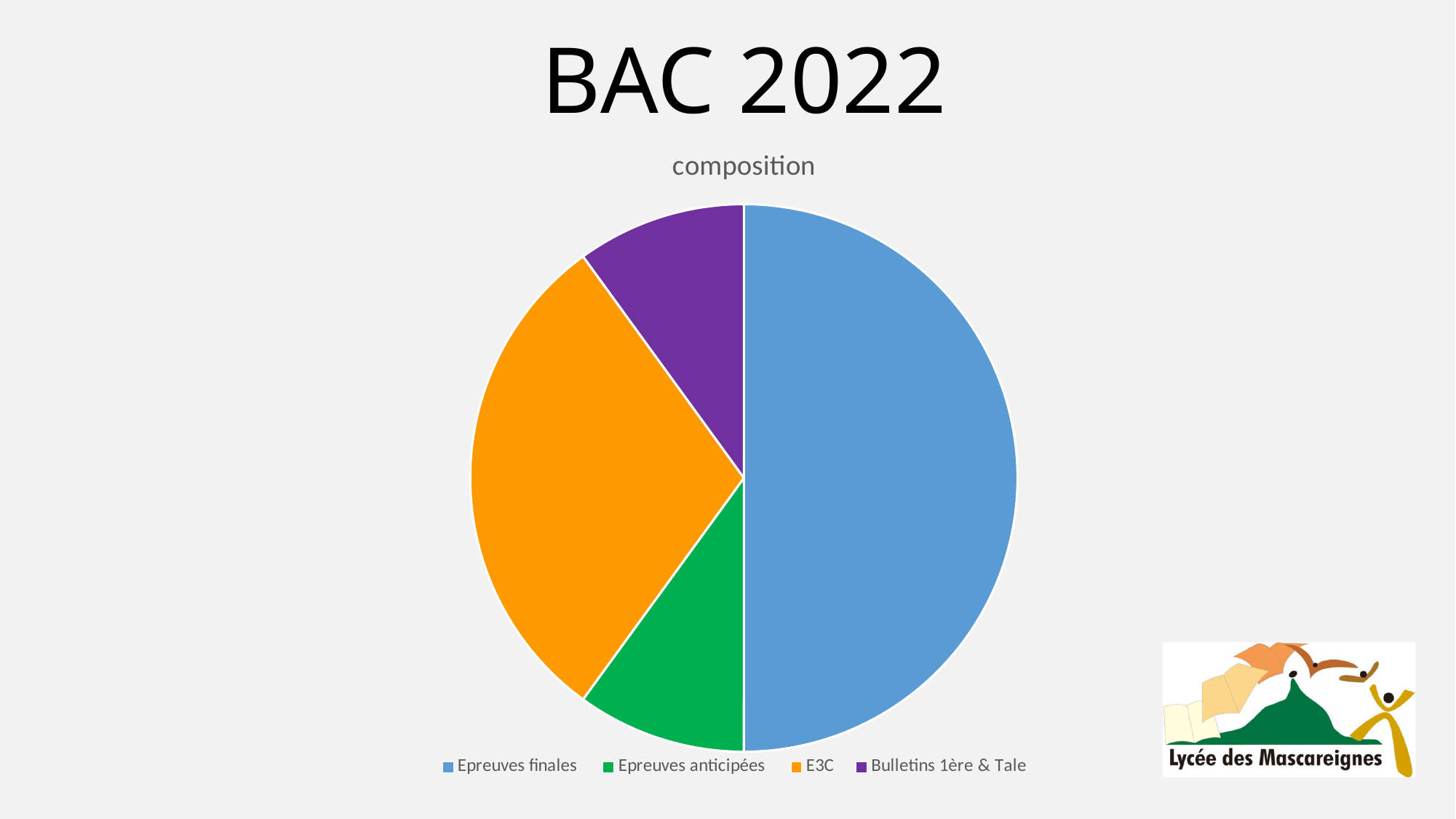
Which category has the largest slice of the pie? Epreuves finales What kind of chart is shown on the slide? pie chart Which slice is larger, E3C or Bulletins 1ère & Tale? E3C How many slices does the pie chart have? 4 Which colour represents E3C in the pie chart? orange What is the title of the chart? composition Which slice is larger, E3C or Epreuves anticipées? E3C Which slice is larger, Epreuves finales or Bulletins 1ère & Tale? Epreuves finales How many entries does the legend list? 4